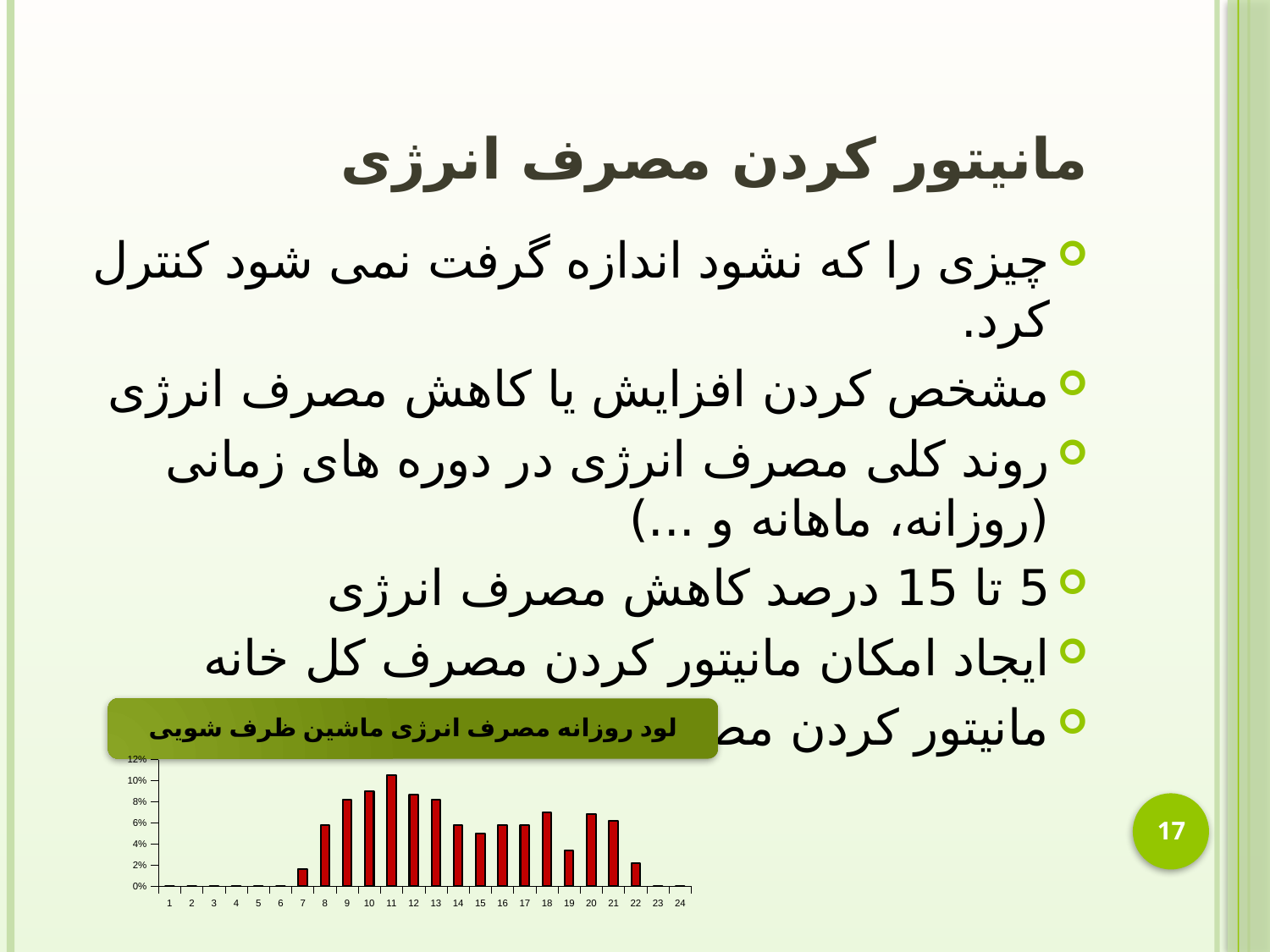
How many categories are shown on the x axis of the bar chart? 24 Is the value for category 22 greater or less than 4%? less Is the value for category 7 greater or less than 4%? less Is the value for category 9 greater or less than 6%? greater Do the values rise or fall from category 7 to category 11? rise Which has the larger value, category 7 or category 8? 8 Which category on the x axis has the highest bar in the chart? 11 Which has the larger value, category 10 or category 19? 10 What colour are the bars in the chart? red What kind of chart is shown at the bottom of the slide? bar chart